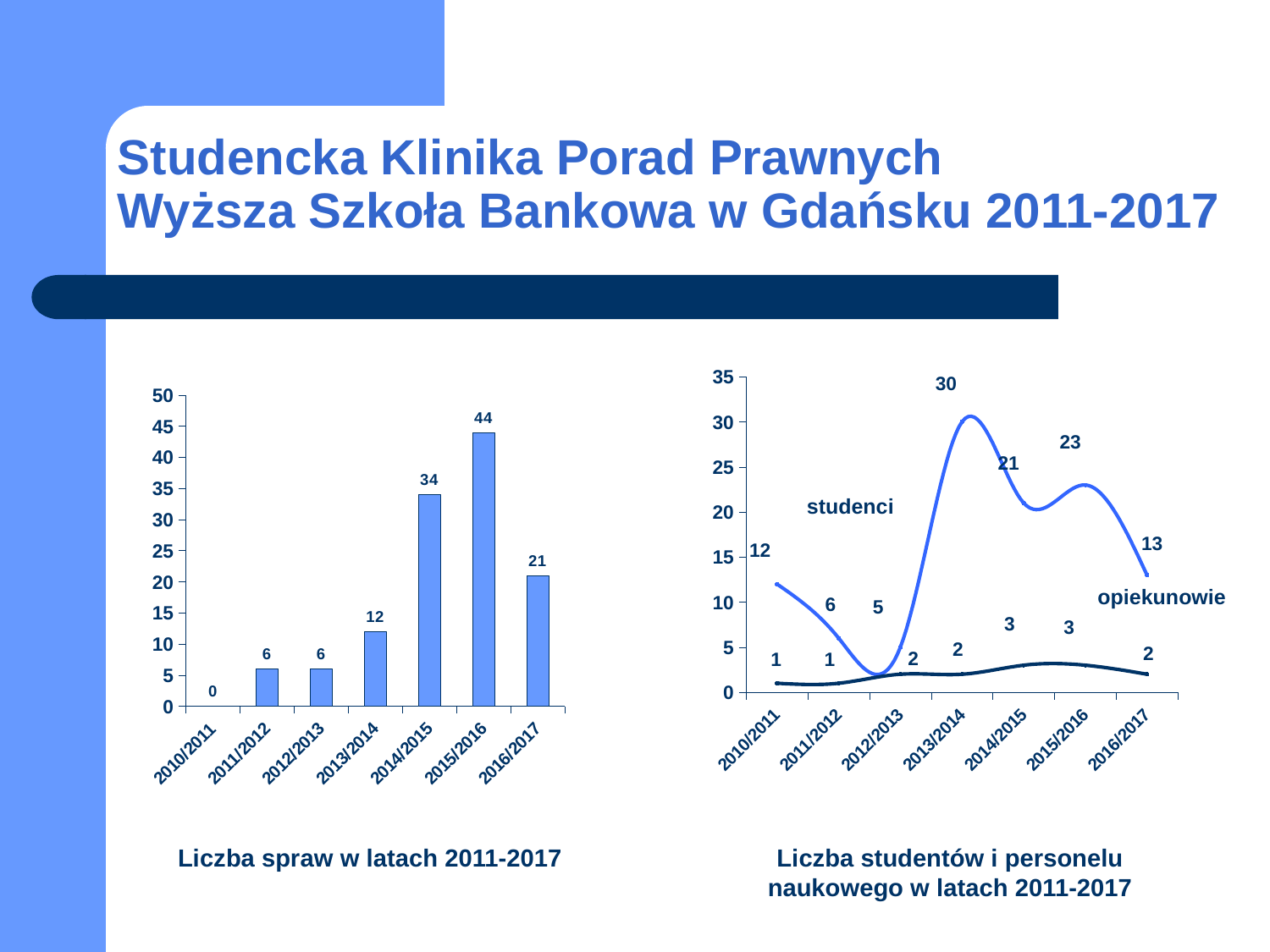
In the chart titled 'Liczba spraw w latach 2011-2017', which year has the highest value? 2015/2016 In the chart titled 'Liczba studentów i personelu naukowego w latach 2011-2017', which is larger for 2016/2017: studenci or opiekunowie? studenci In the chart titled 'Liczba spraw w latach 2011-2017', which year has the lowest value? 2010/2011 What kind of chart is the one titled 'Liczba studentów i personelu naukowego w latach 2011-2017'? line chart In the chart titled 'Liczba studentów i personelu naukowego w latach 2011-2017', what is the value for opiekunowie in 2014/2015? 3 In the chart titled 'Liczba spraw w latach 2011-2017', how many years are shown on the x axis? 7 In the chart titled 'Liczba studentów i personelu naukowego w latach 2011-2017', in which year is the studenci value highest? 2013/2014 In the chart titled 'Liczba spraw w latach 2011-2017', what is the difference between the values for 2015/2016 and 2014/2015? 10 In the chart titled 'Liczba studentów i personelu naukowego w latach 2011-2017', what is the value for studenci in 2013/2014? 30 In the chart titled 'Liczba spraw w latach 2011-2017', what is the value for 2015/2016? 44 What kind of chart is the one titled 'Liczba spraw w latach 2011-2017'? bar chart In the chart titled 'Liczba studentów i personelu naukowego w latach 2011-2017', what is the difference between studenci and opiekunowie in 2015/2016? 20